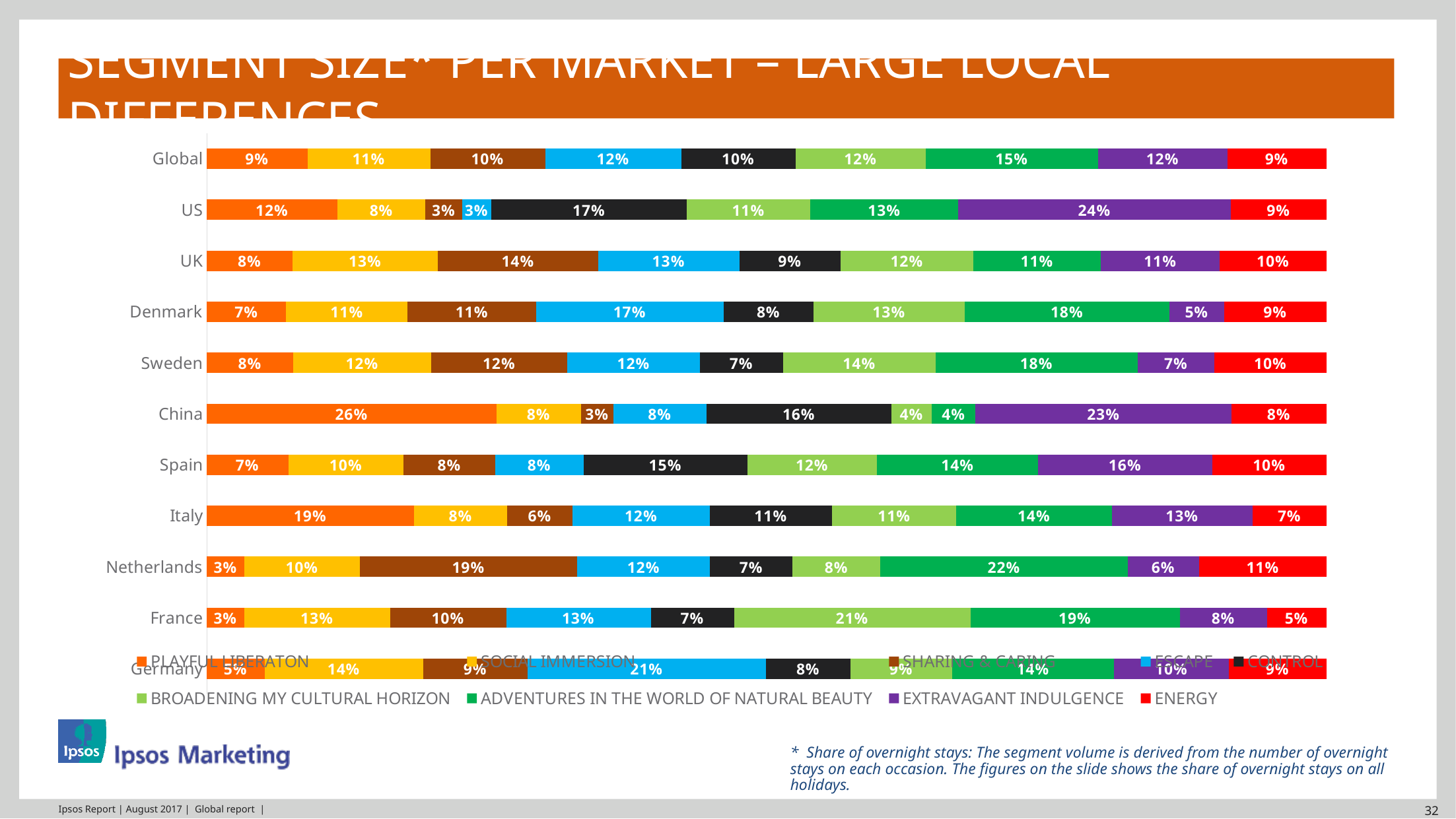
What is the ESCAPE share for Germany? 21% What is the EXTRAVAGANT INDULGENCE share for the US? 24% What is the BROADENING MY CULTURAL HORIZON share for France? 21% What is the PLAYFUL LIBERATON share for China? 26% How many markets (including Global) are plotted on the chart? 11 What is the difference between the ADVENTURES IN THE WORLD OF NATURAL BEAUTY share for the Netherlands and for Global? 7% Which legend entry is shown in red? ENERGY Which market has the highest PLAYFUL LIBERATON share? China What type of chart is shown on the slide? Stacked bar chart How many series does the legend list? 9 Which market has the lowest ENERGY share? France Which is larger: the CONTROL share for the US or for the UK? US